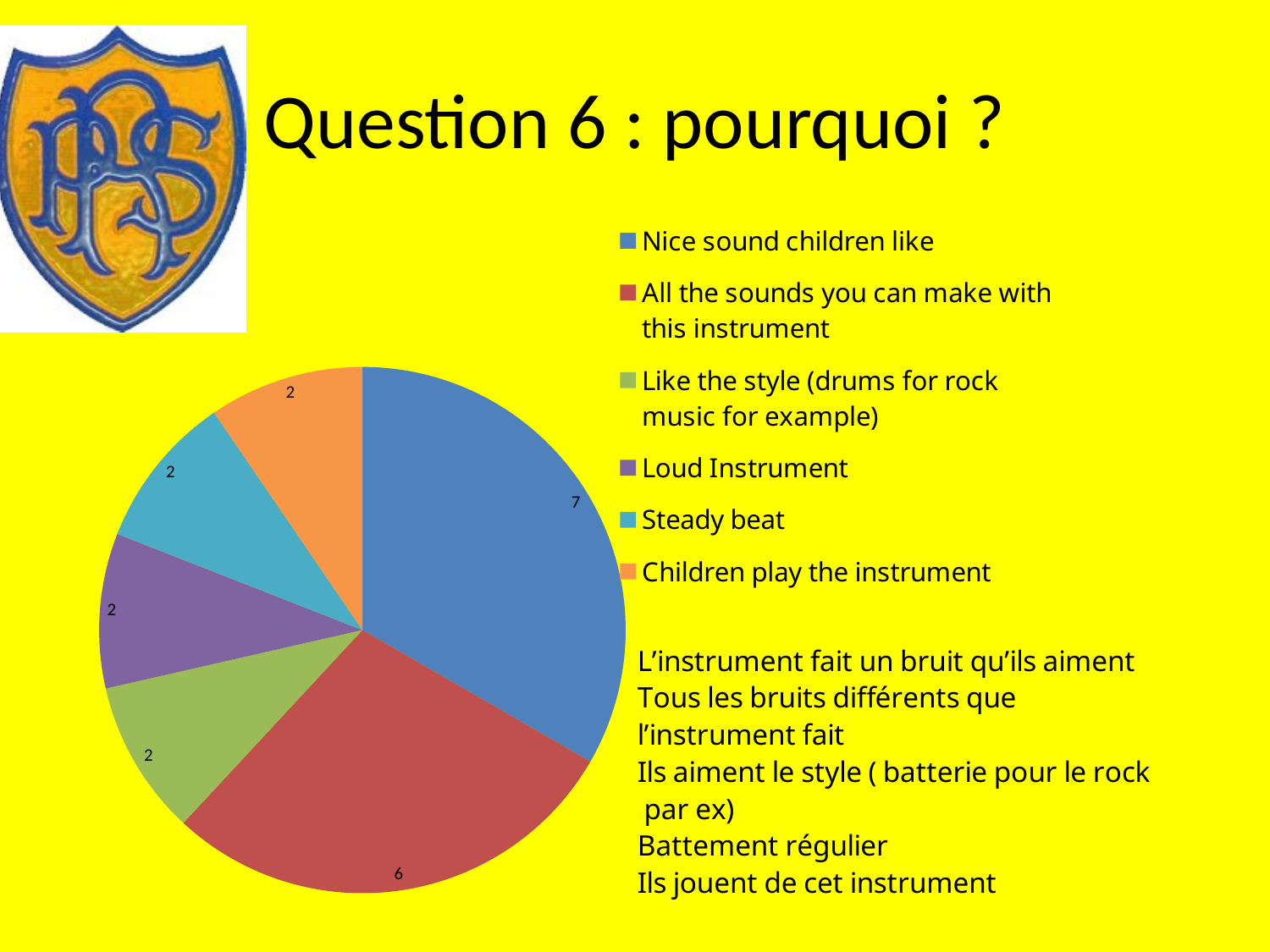
How many categories does the pie chart have? 6 Which category has the largest slice of the pie? Nice sound children like What type of chart is shown on the slide? pie chart What is the total of all the slice values in the pie chart? 21 What is the value for "All the sounds you can make with this instrument"? 6 Which is larger: the value for "Loud Instrument" or the value for "All the sounds you can make with this instrument"? All the sounds you can make with this instrument What is the value for "Nice sound children like"? 7 What share of the total does the "Nice sound children like" slice represent, as a fraction? 7/21 What is the value for "Steady beat"? 2 What is the difference between the values for "Nice sound children like" and "All the sounds you can make with this instrument"? 1 What colour is the slice for "Loud Instrument"? purple What is the value for "Children play the instrument"? 2